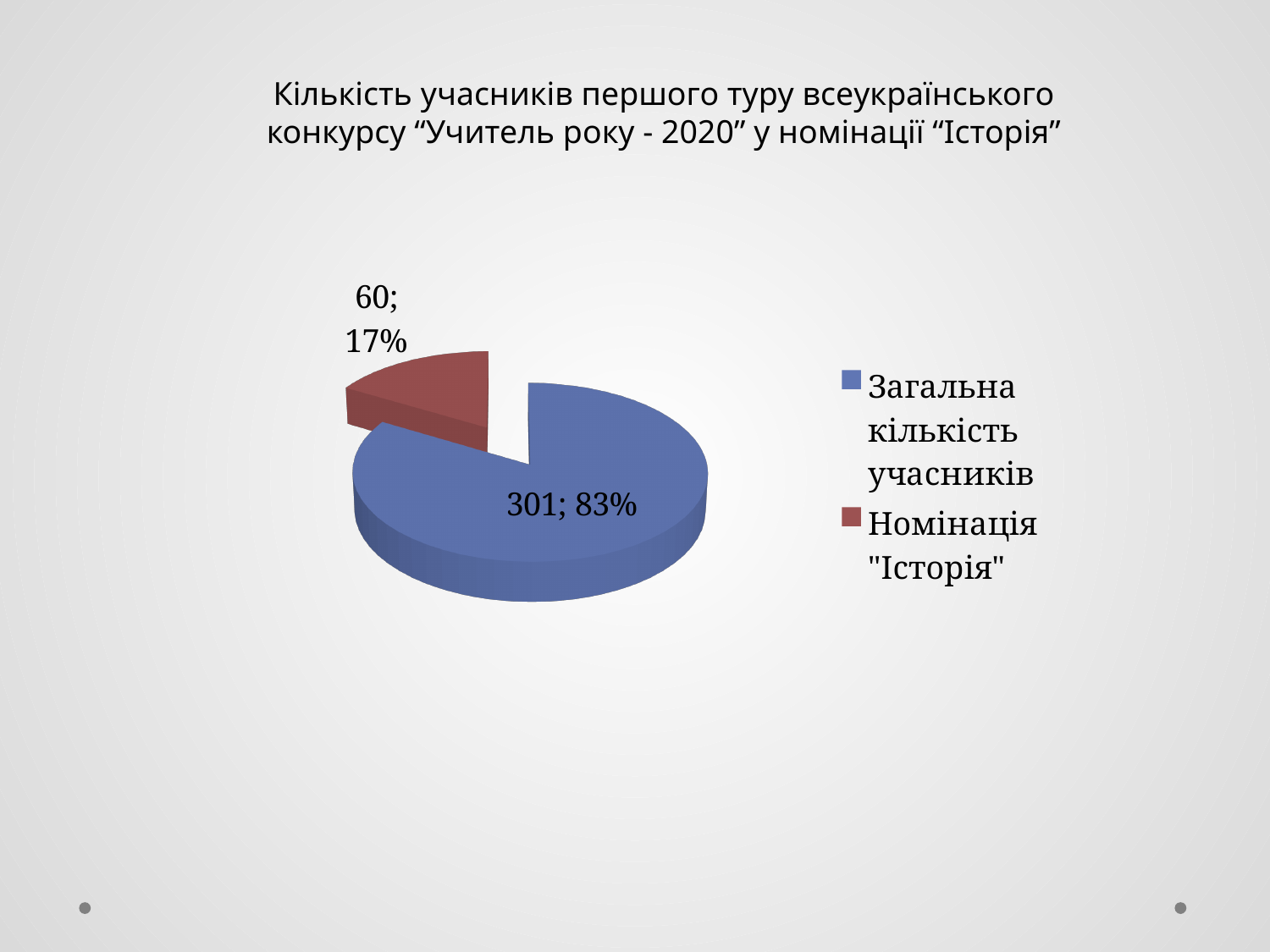
What share of the pie does "Загальна кількість учасників" take? 83% How many slices does the pie chart have? 2 Which slice is the smallest? Номінація "Історія" What kind of chart is shown on the slide? pie chart What colour is the slice for "Номінація "Історія""? red Which is larger: "Загальна кількість учасників" or "Номінація "Історія""? Загальна кількість учасників How many entries does the legend list? 2 Which slice is the largest? Загальна кількість учасників What share of the pie does "Номінація "Історія"" take? 17% What is the difference between the values for "Загальна кількість учасників" and "Номінація "Історія""? 241 What is the value for "Загальна кількість учасників"? 301 What is the value for "Номінація "Історія""? 60